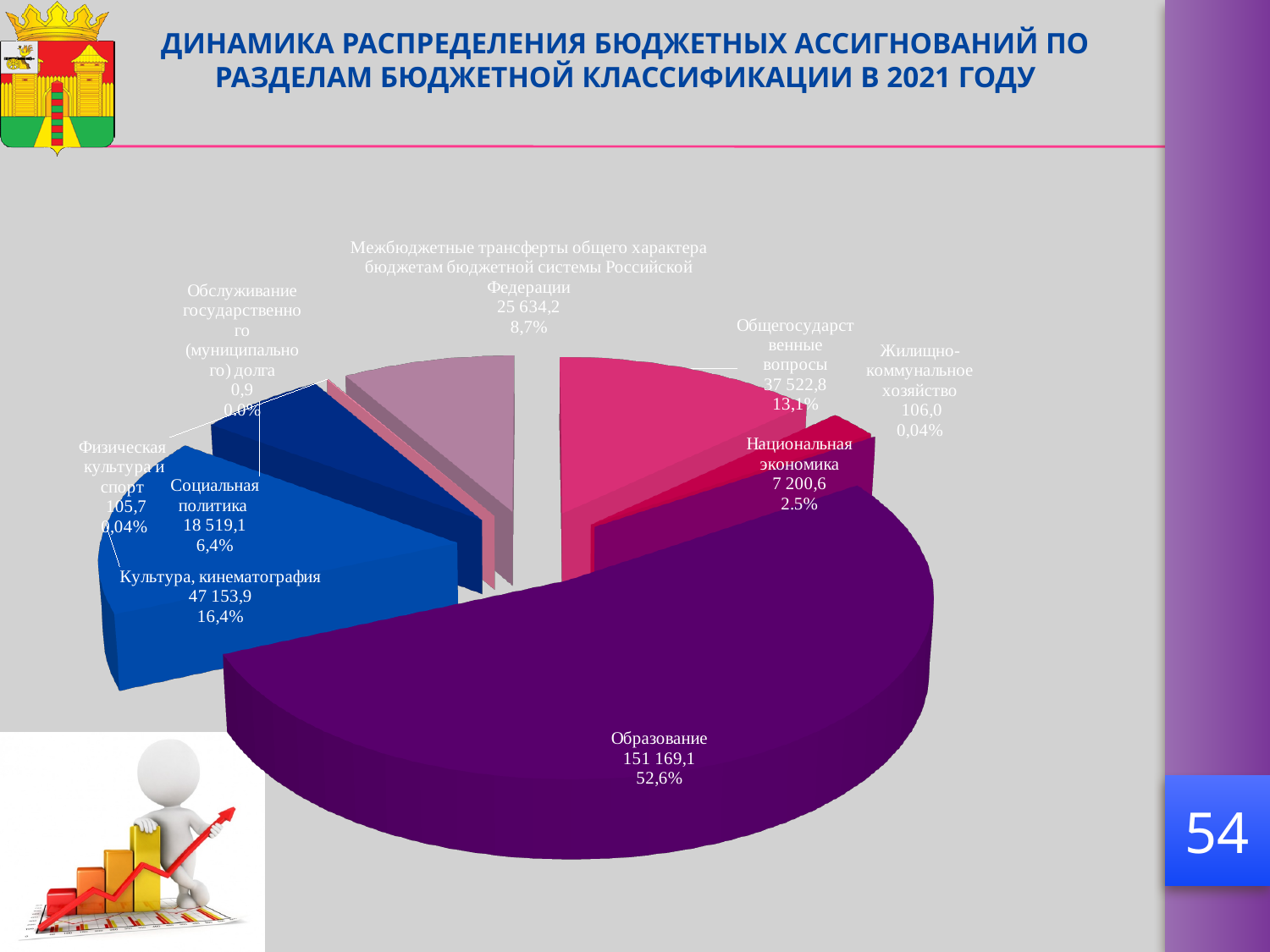
How many categories (slices) does the pie chart show? 9 What value is shown for Образование? 151 169,1 Which category has the smallest value in the pie chart? Обслуживание государственного (муниципального) долга Which is larger: Национальная экономика or Межбюджетные трансферты общего характера бюджетам бюджетной системы Российской Федерации? Межбюджетные трансферты общего характера бюджетам бюджетной системы Российской Федерации What share of the pie does Образование account for? 52,6% What year does the chart title refer to? 2021 What value is shown for Социальная политика? 18 519,1 What value is shown for Культура, кинематография? 47 153,9 What kind of chart is shown on the slide? Pie chart Which category has the largest slice of the pie? Образование What is the difference between the values for Образование and Культура, кинематография? 104 015,2 What percentage is shown for Общегосударственные вопросы? 13,1%